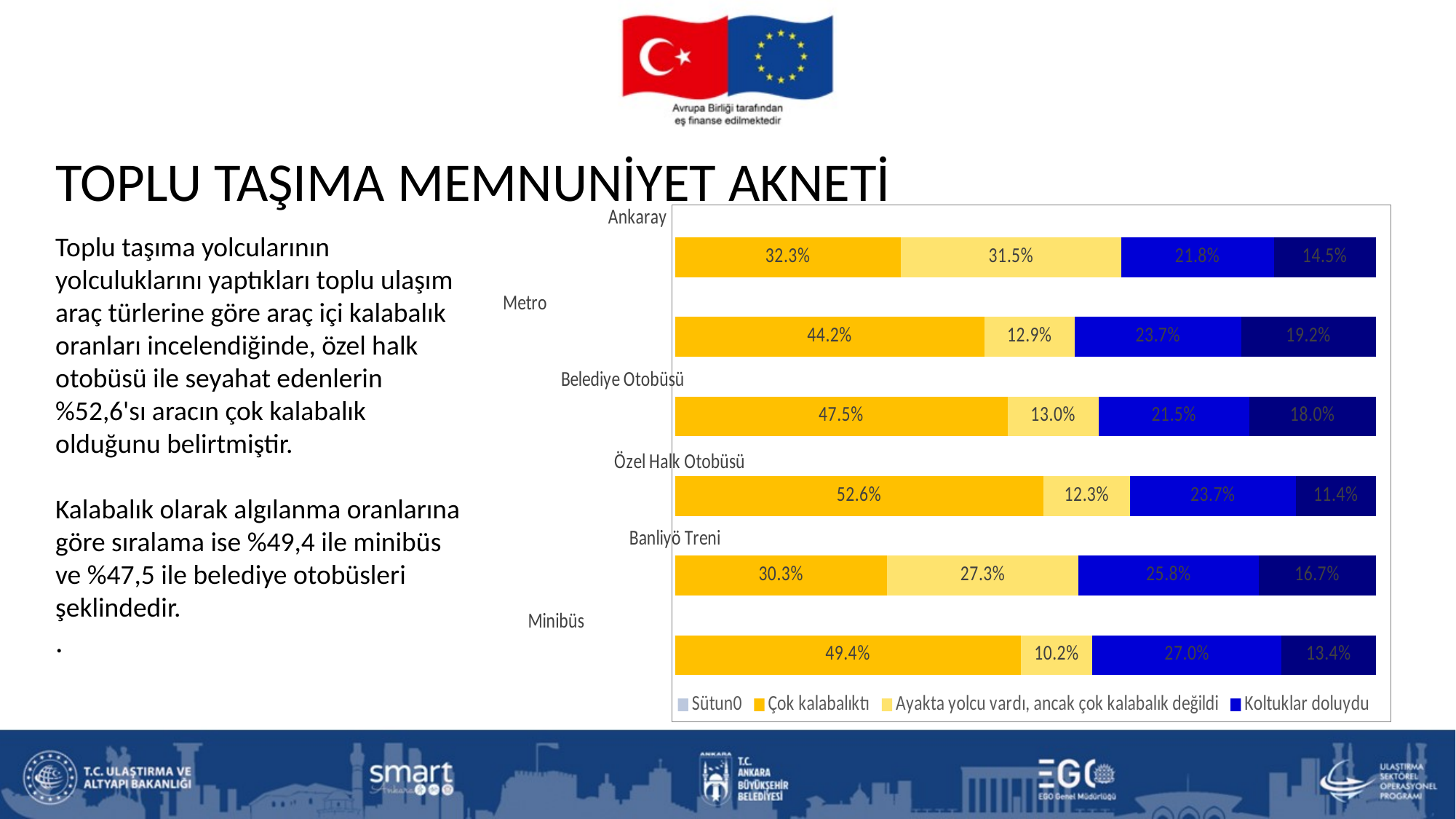
What colour are the "Çok kalabalıktı" segments in the chart? orange-yellow What is the difference between the "Çok kalabalıktı" values for Özel Halk Otobüsü and Belediye Otobüsü? 5.1% What is the "Koltuklar doluydu" value for Banliyö Treni? 25.8% Which category has the highest "Çok kalabalıktı" value? Özel Halk Otobüsü What type of chart is shown on the slide? stacked bar chart What is the "Çok kalabalıktı" value for Özel Halk Otobüsü? 52.6% What is the "Ayakta yolcu vardı, ancak çok kalabalık değildi" value for Ankaray? 31.5% How many series does the legend list? 4 Which has a larger "Ayakta yolcu vardı, ancak çok kalabalık değildi" value, Metro or Banliyö Treni? Banliyö Treni What is the "Çok kalabalıktı" value for Minibüs? 49.4% Which category has the lowest "Çok kalabalıktı" value? Banliyö Treni How many categories are shown in the chart? 6